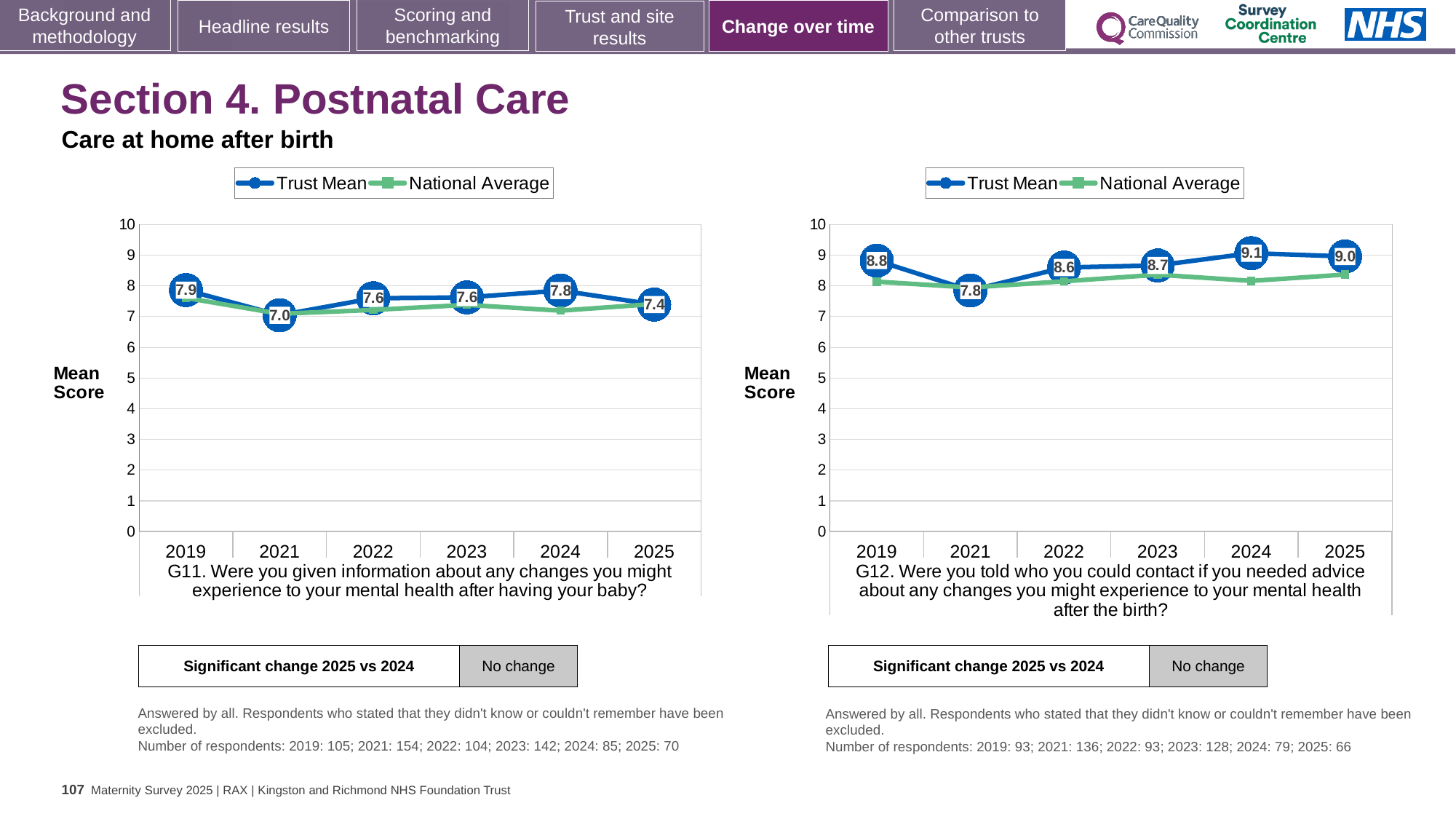
In the G11 chart, is the Trust Mean score for 2024 higher or lower than for 2025? higher In the G11 chart, which year has the highest Trust Mean score? 2019 In the G12 chart, what is the difference between the Trust Mean scores for 2024 and 2021? 1.3 In the G12 chart, does the Trust Mean rise or fall from 2021 to 2024? rise What type of chart is the G11 chart? line chart In the G12 chart, which year has the lowest Trust Mean score? 2021 In the G11 chart, what is the Trust Mean score for 2025? 7.4 In the G12 chart, is the National Average value for 2021 greater or less than 9? less In the G12 chart, what is the Trust Mean score for 2024? 9.1 How many series does the legend of the G12 chart list? 2 In the G11 chart, what is the Trust Mean score for 2021? 7.0 How many years are plotted on the x axis of the G11 chart? 6